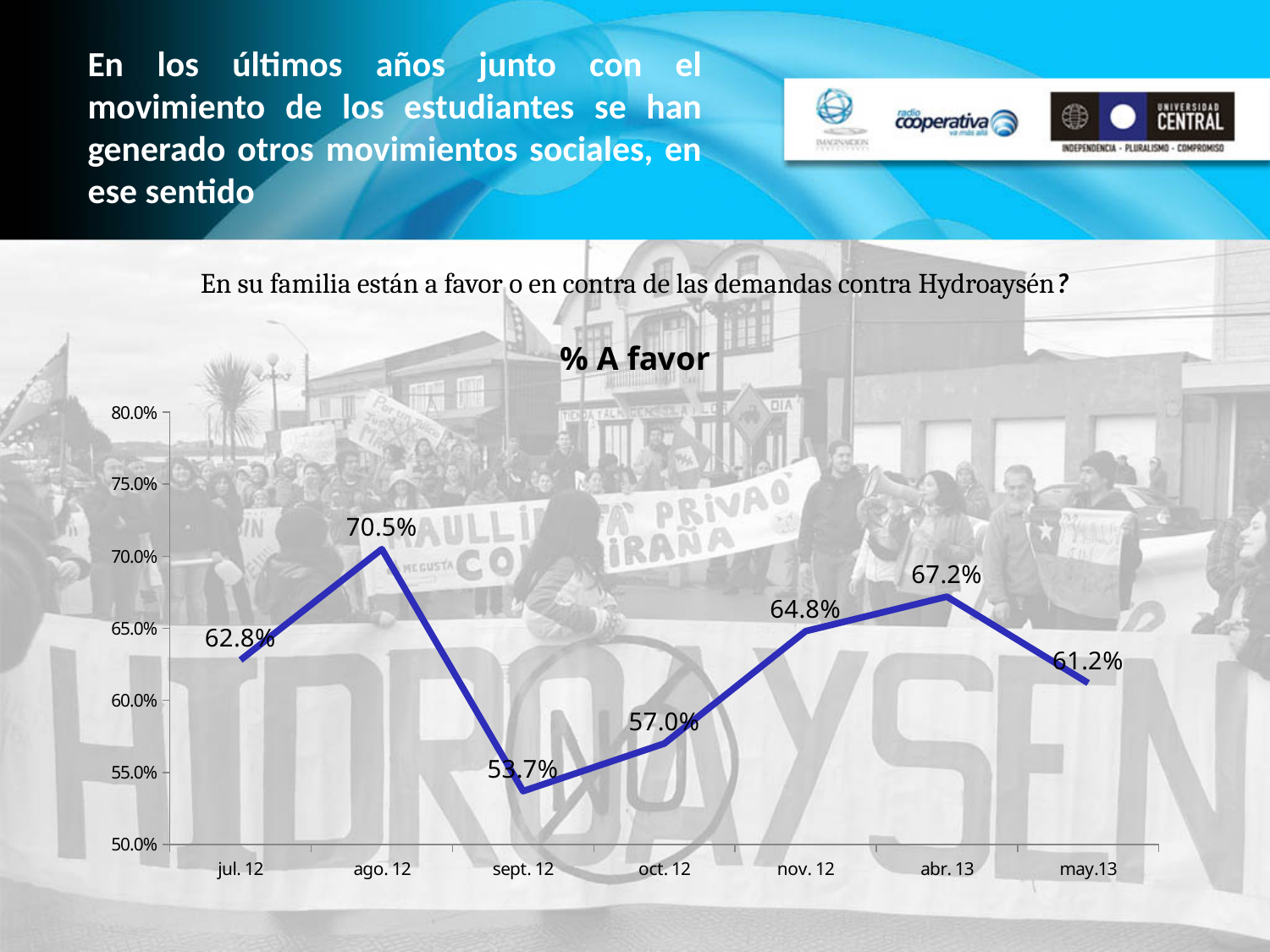
Which month has the lowest value? sept. 12 How many data points are plotted on the line? 7 What kind of chart is shown? line chart What is the value for ago. 12? 70.5% What is the title of the chart? % A favor Do the values rise or fall from sept. 12 to abr. 13? rise Which is larger, the value for nov. 12 or the value for abr. 13? abr. 13 Which month has the highest value? ago. 12 What is the value for sept. 12? 53.7% Is the value for oct. 12 greater or less than 60.0%? less What is the difference between the values for ago. 12 and sept. 12? 16.8% What is the value for may.13? 61.2%